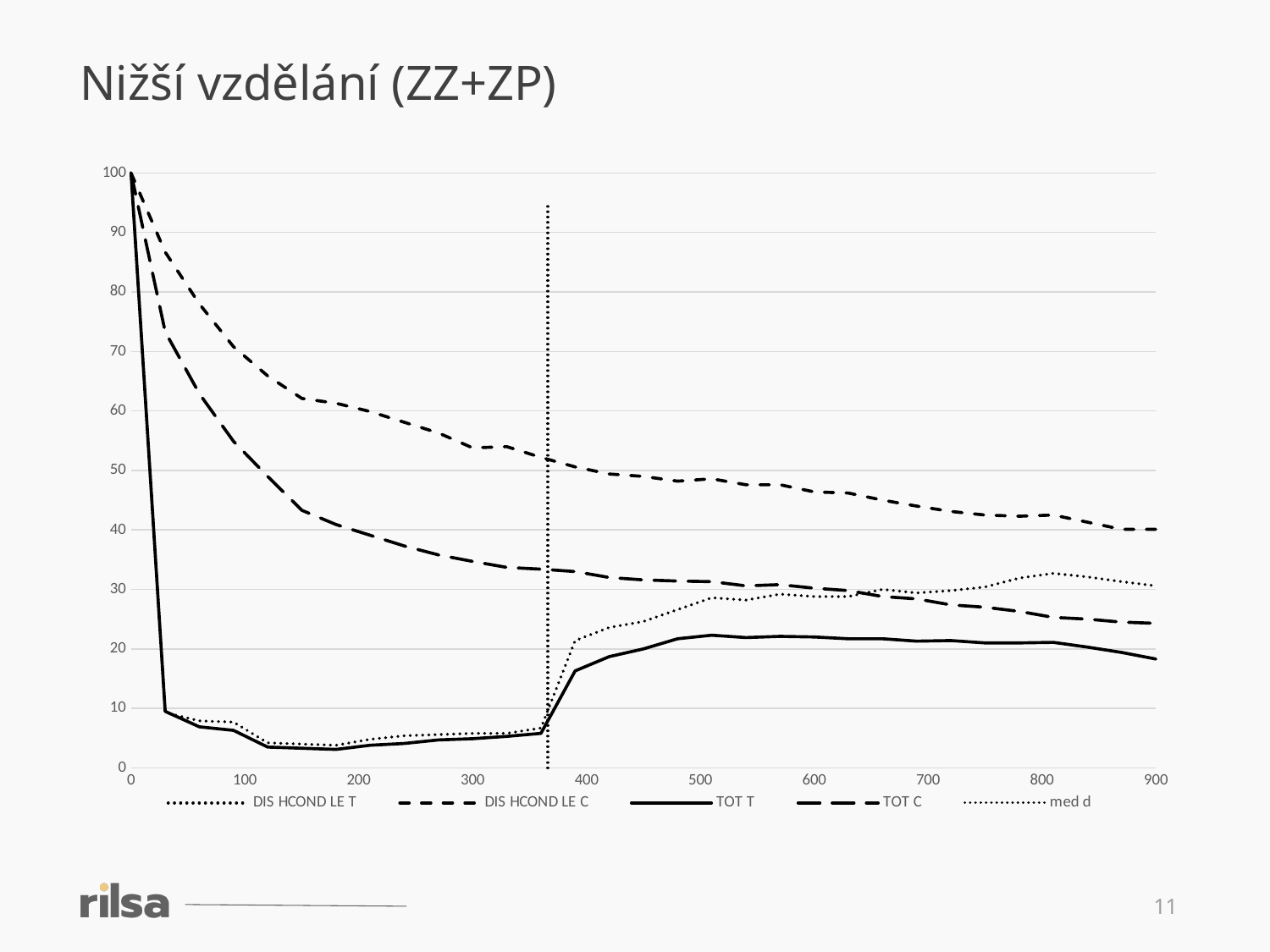
Does the TOT C series rise or fall from x = 0 to x = 900? fall Is the value of the TOT T series at x = 500 greater or less than 30? less Which series has the highest value at x = 900? DIS HCOND LE C How many series does the legend list? 5 At x = 200, which series has the larger value, TOT T or TOT C? TOT C Is the value of the DIS HCOND LE C series at x = 900 greater or less than 30? greater What kind of chart is shown on the slide? line chart What is the value of the TOT C series at x = 0? 100 Is the value of the DIS HCOND LE C series at x = 100 greater or less than 60? greater What is the title of the chart? Nižší vzdělání (ZZ+ZP) At x = 900, which series has the larger value, DIS HCOND LE C or TOT C? DIS HCOND LE C